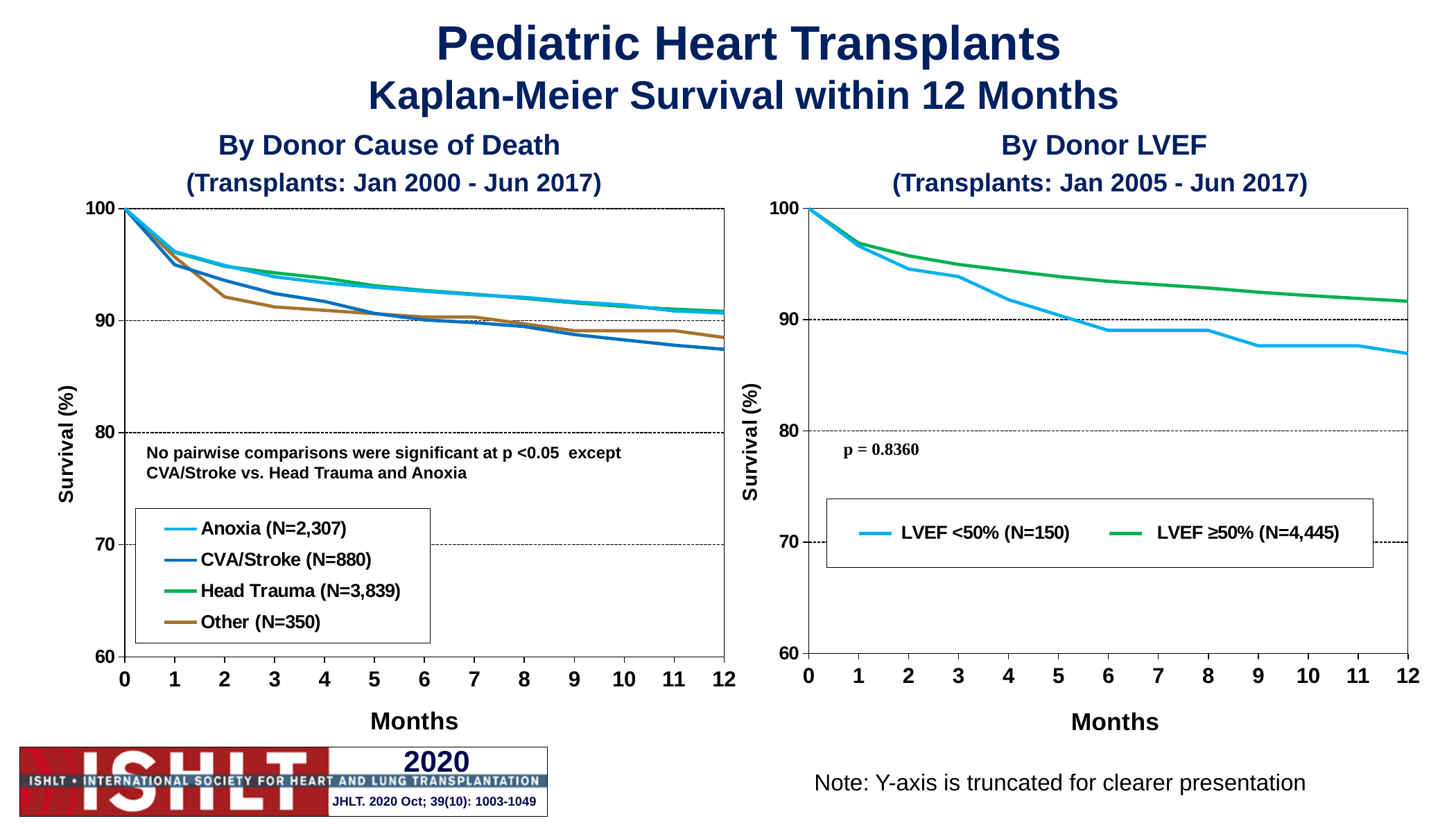
In the 'By Donor LVEF' chart, which series has higher survival at 12 months, LVEF <50% or LVEF ≥50%? LVEF ≥50% How many series does the legend of the 'By Donor LVEF' chart list? 2 In the 'By Donor Cause of Death' chart, what is the survival (%) for all series at month 0? 100 In the 'By Donor Cause of Death' chart, which series has the lowest survival at 12 months? CVA/Stroke What type of chart is the 'By Donor Cause of Death' chart on the left? Line chart In the 'By Donor Cause of Death' chart, is the survival for Head Trauma at 12 months greater or less than 90? greater In the 'By Donor LVEF' chart, does survival rise or fall as months increase? Fall What p-value is shown on the 'By Donor LVEF' chart? p = 0.8360 In the 'By Donor LVEF' chart, is the survival for LVEF ≥50% at 12 months greater or less than 90? greater How many series does the legend of the 'By Donor Cause of Death' chart list? 4 In the 'By Donor LVEF' chart, is the survival for LVEF <50% at 9 months greater or less than 90? less